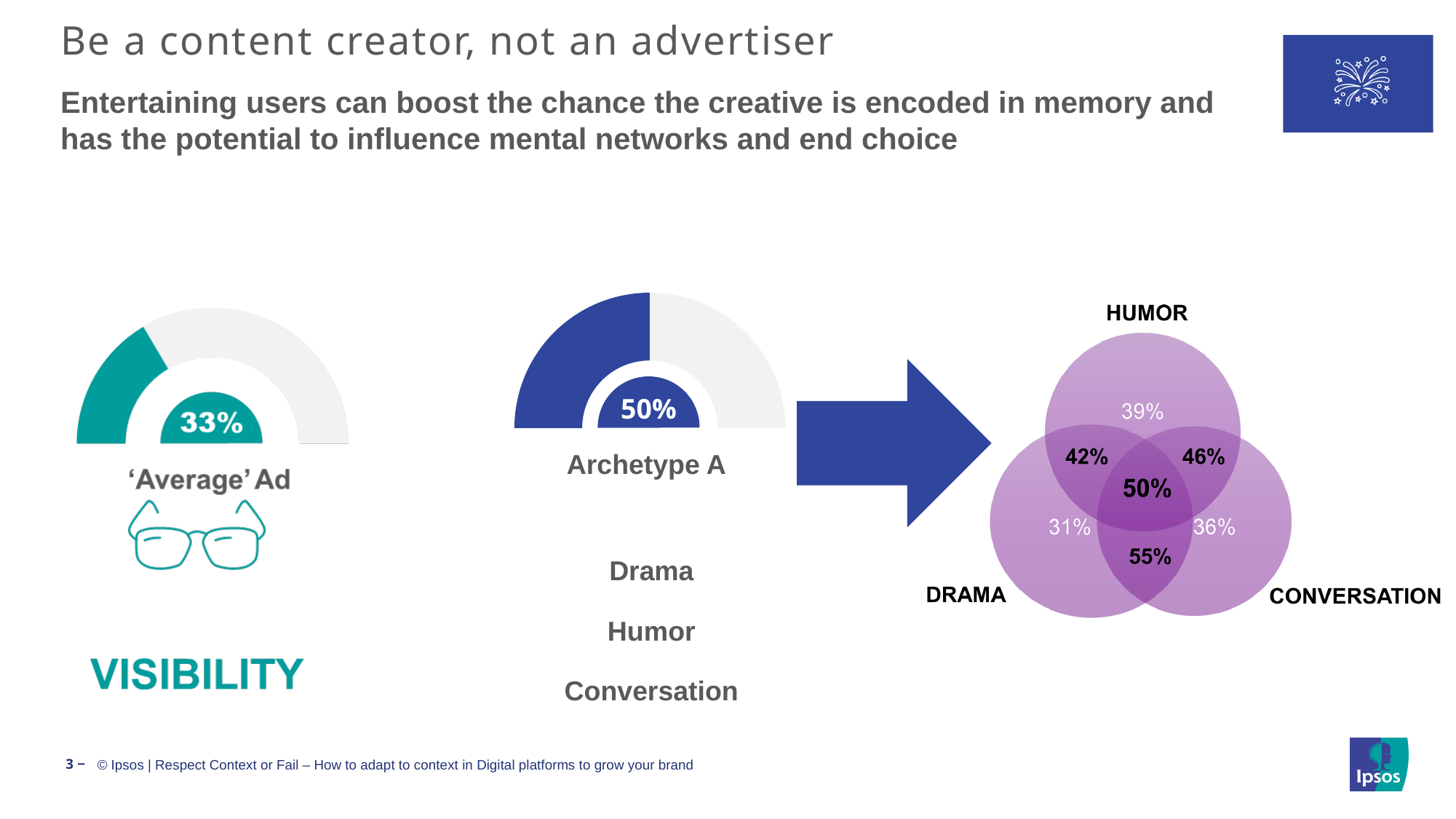
Which has the higher value, the 'Average' Ad gauge or the Archetype A gauge? Archetype A In the Venn diagram on the right, what value is shown in the Humor-only region? 39% On the 'Average' Ad gauge chart on the left, what value is shown? 33% How many circles does the Venn diagram on the right contain? 3 In the Venn diagram on the right, what value is shown in the Conversation-only region? 36% In the Venn diagram on the right, what value is shown in the Drama-only region? 31% On the Archetype A gauge chart in the middle, what value is shown? 50% In the Venn diagram on the right, what value is shown in the centre where all three circles overlap? 50% In the Venn diagram on the right, which region has the highest value? Drama and Conversation overlap (55%) What is the difference between the Archetype A gauge value and the 'Average' Ad gauge value? 17% In the Venn diagram on the right, which single-category region has the lowest value? Drama (31%) In the Venn diagram on the right, what value is shown where Drama and Conversation overlap (excluding Humor)? 55%